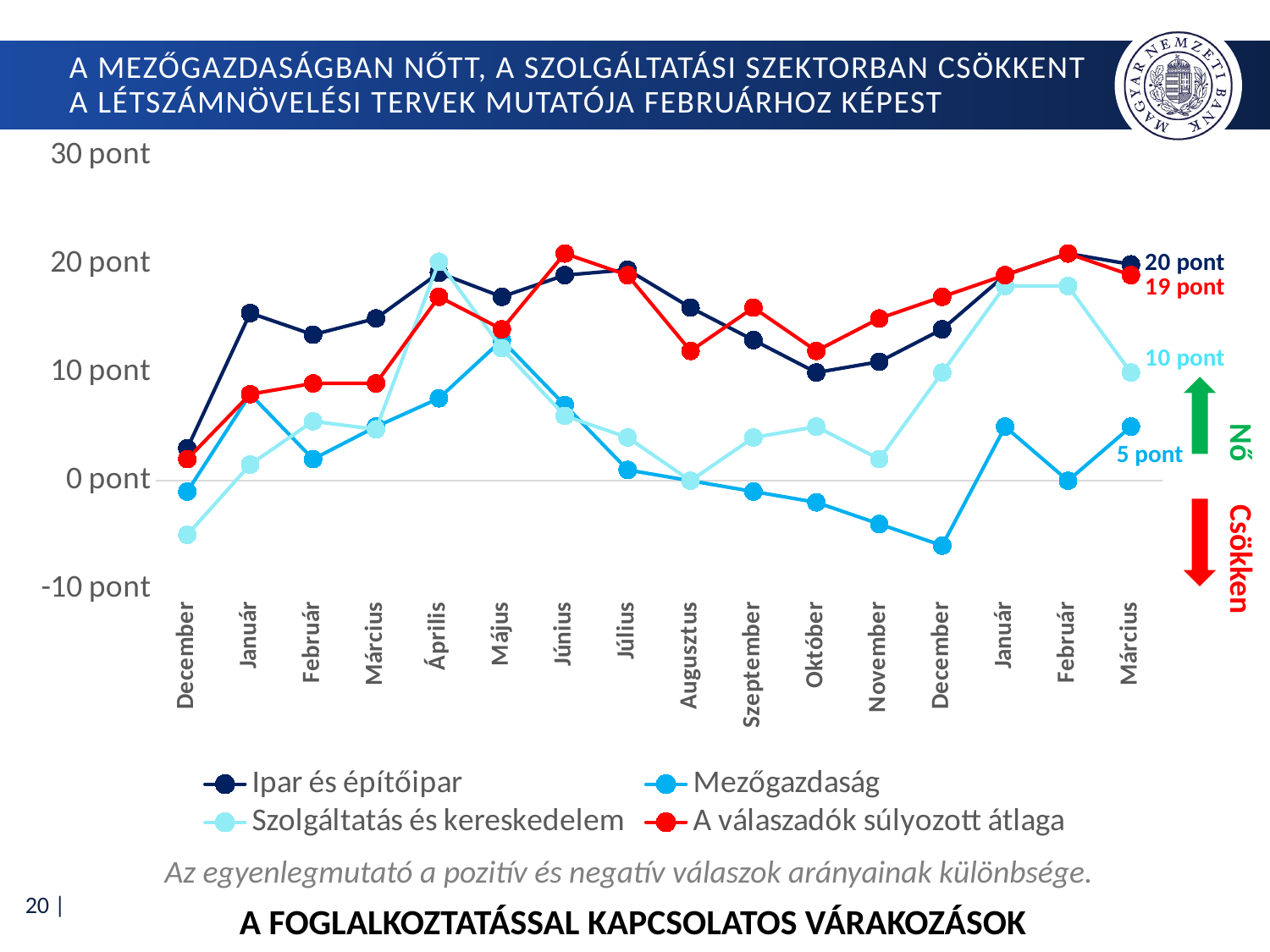
What is the value for Szolgáltatás és kereskedelem in the final Március? 10 pont Which series has the highest value in the final Március? Ipar és építőipar Is the value for Mezőgazdaság in the second December greater or less than 0 pont? less Does the Mezőgazdaság line rise or fall from Június to the second December? fall What is the value for Mezőgazdaság in the final Március? 5 pont What kind of chart is shown on the slide? line chart How many months are shown along the x axis? 16 Which series has the lowest value in the final Március? Mezőgazdaság What is the value for A válaszadók súlyozott átlaga in the final Március? 19 pont What is the value for Ipar és építőipar in the final Március? 20 pont What is the difference between Ipar és építőipar and Mezőgazdaság in the final Március? 15 pont How many series does the legend list? 4